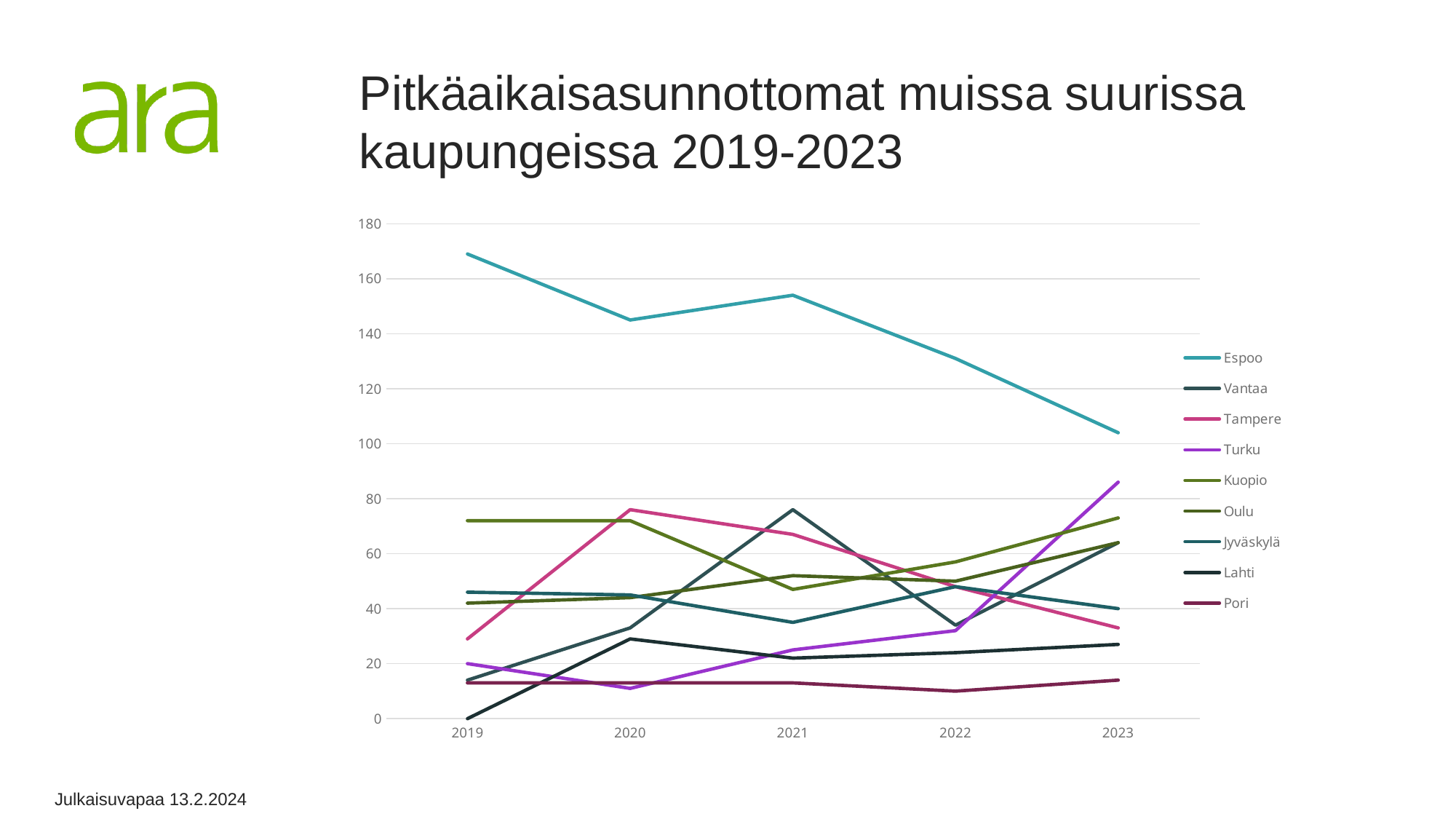
Which city has the lowest value in 2023? Pori What kind of chart is shown on the slide? line chart Which city has the highest value in 2019? Espoo Do the values for Turku rise or fall from 2020 to 2023? rise Do the values for Espoo rise or fall overall from 2019 to 2023? fall Is the value for Turku in 2023 greater or less than 80? greater How many series does the legend list? 9 Which city has the lowest value in 2019? Lahti How many years are shown on the x axis? 5 Which is larger in 2020, the value for Espoo or the value for Tampere? Espoo Is the value for Vantaa in 2021 greater or less than 60? greater Is the value for Espoo in 2019 greater or less than 160? greater